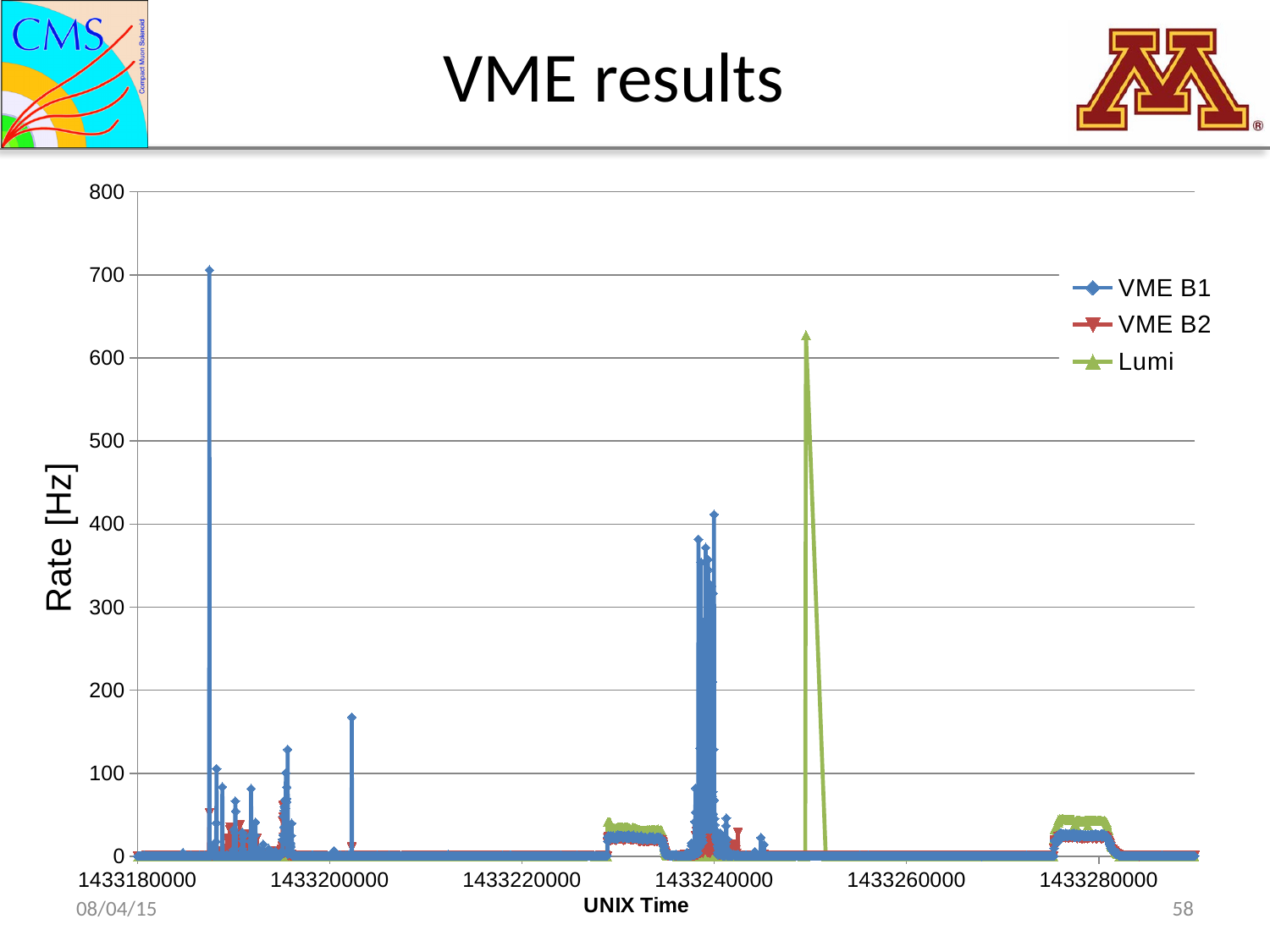
What are the names of the series listed in the legend? VME B1, VME B2, Lumi Is the highest peak of the VME B2 series greater or less than 100? less Is the highest peak of the Lumi series greater or less than 600? greater Which series has a higher peak, VME B1 or Lumi? VME B1 Which series has the lowest maximum value on the chart? VME B2 What is the label of the y axis? Rate [Hz] What kind of chart is shown on the slide? line chart What is the maximum value shown on the y axis? 800 Which series reaches the highest peak value on the chart? VME B1 How many series does the legend list? 3 Is the highest peak of the Lumi series greater or less than 700? less